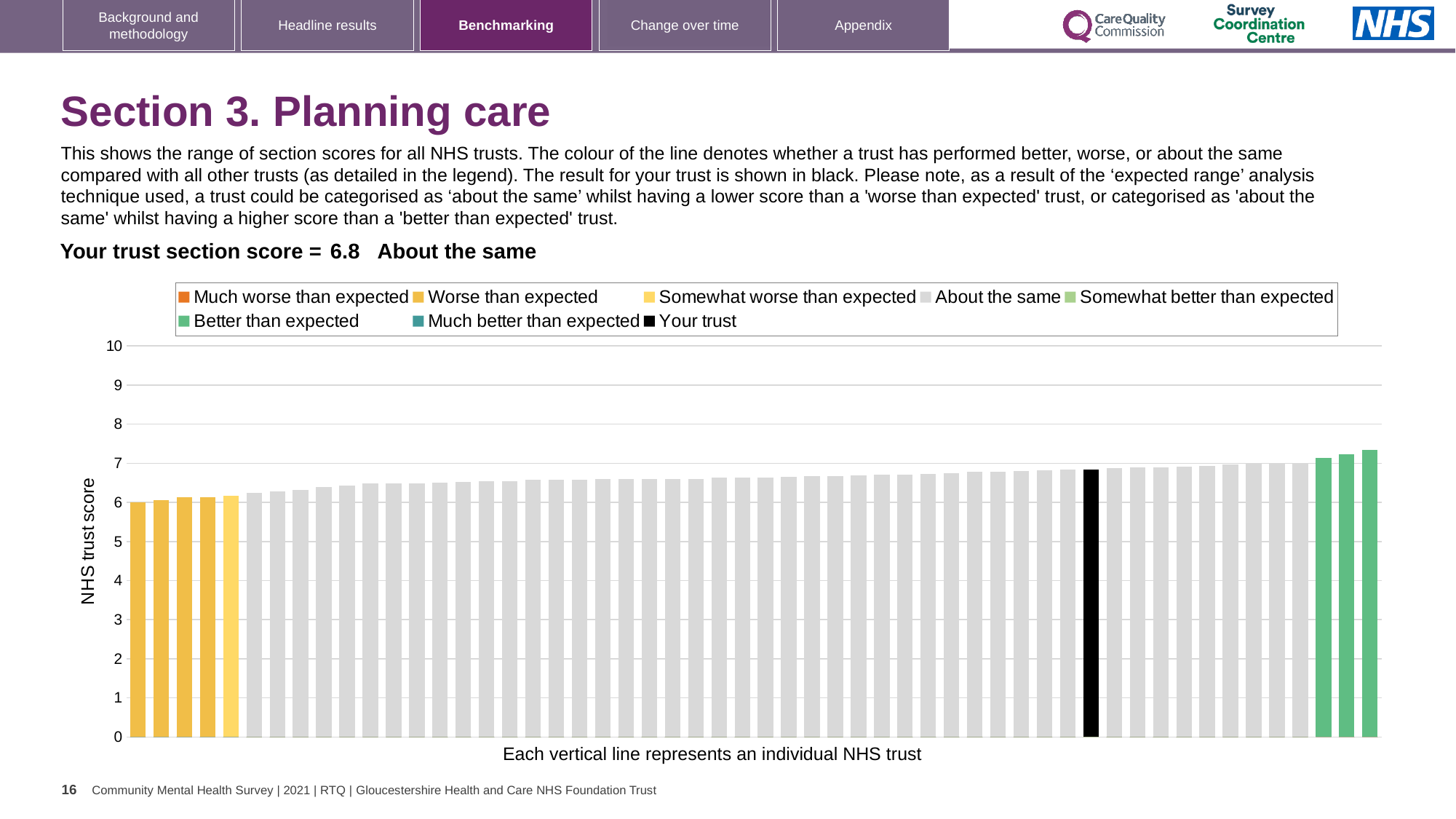
Which is larger: the bar for your trust or the tallest green 'Better than expected' bar? the tallest green bar How is your trust's score categorised compared with other trusts? About the same Is the value of the highest bar in the chart greater or less than 7? greater How many bars are coloured as 'Better than expected' (green)? 3 What colour is the bar representing your trust? black Is the value for your trust greater or less than 6? greater Do the bar values rise or fall from left to right along the x axis? rise What kind of chart is shown on the slide? bar chart What is the label on the vertical axis of the chart? NHS trust score What is the section score for your trust shown on the slide? 6.8 How many entries does the chart legend list? 8 Is the value of the lowest bar in the chart greater or less than 7? less